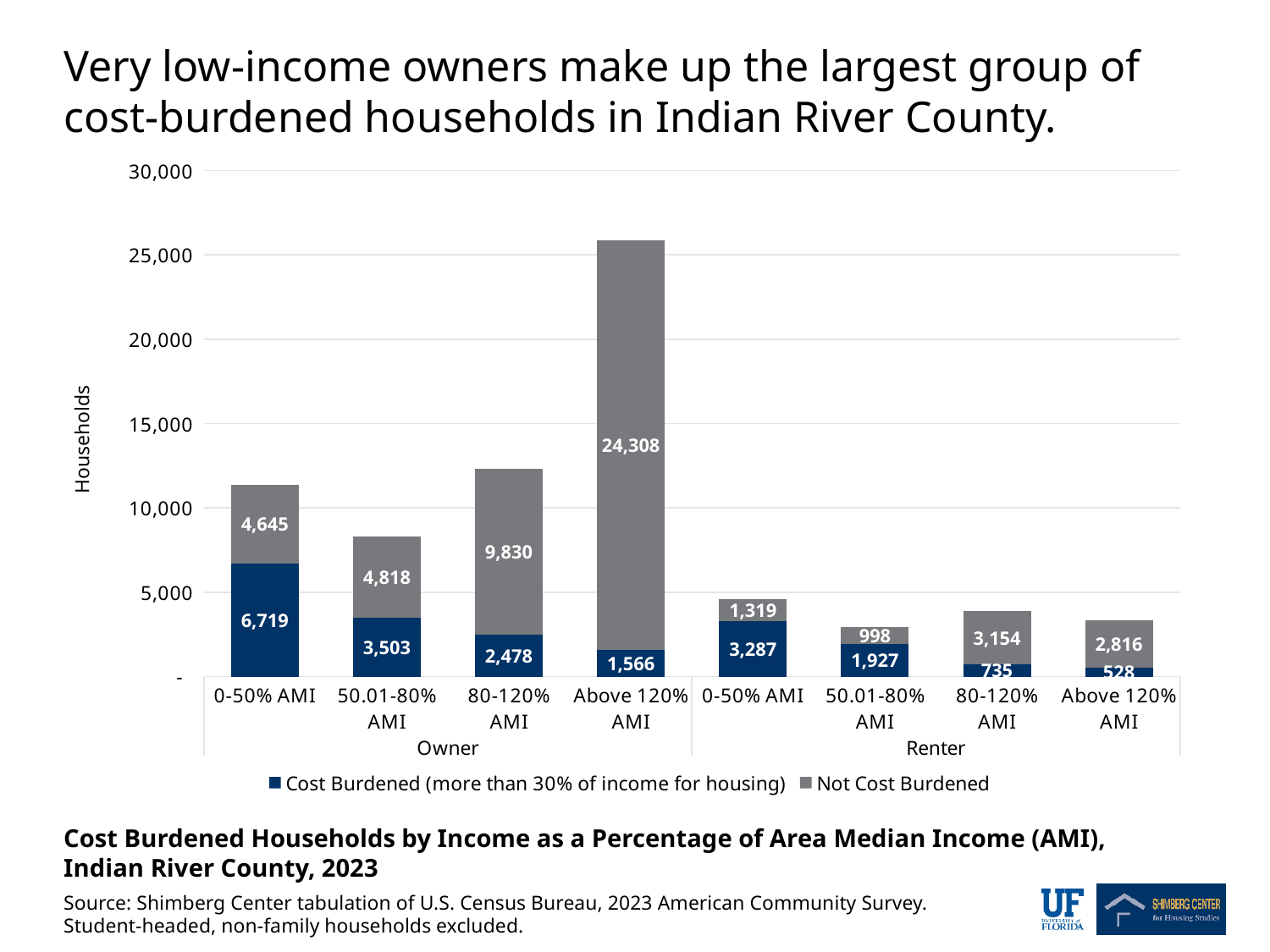
What kind of chart is shown on the slide? Stacked bar chart Which group has the smallest number of cost-burdened households? Renter, Above 120% AMI Which group has the largest number of cost-burdened households? Owner, 0-50% AMI What is the difference between the cost-burdened owner households in the 0-50% AMI group and the cost-burdened renter households in the 0-50% AMI group? 3,432 How many series does the legend list? 2 What is the number of cost-burdened renter households in the 50.01-80% AMI group? 1,927 Is the total height of the Owner Above 120% AMI bar greater or less than 25,000? greater How many income groups (bars) are shown on the chart? 8 What is the number of cost-burdened owner households in the 0-50% AMI group? 6,719 What is the number of not cost-burdened owner households in the Above 120% AMI group? 24,308 What is the total number of renter households in the 0-50% AMI group (cost burdened plus not cost burdened)? 4,606 Which is larger: the number of not cost-burdened owner households at 80-120% AMI or at 50.01-80% AMI? 80-120% AMI